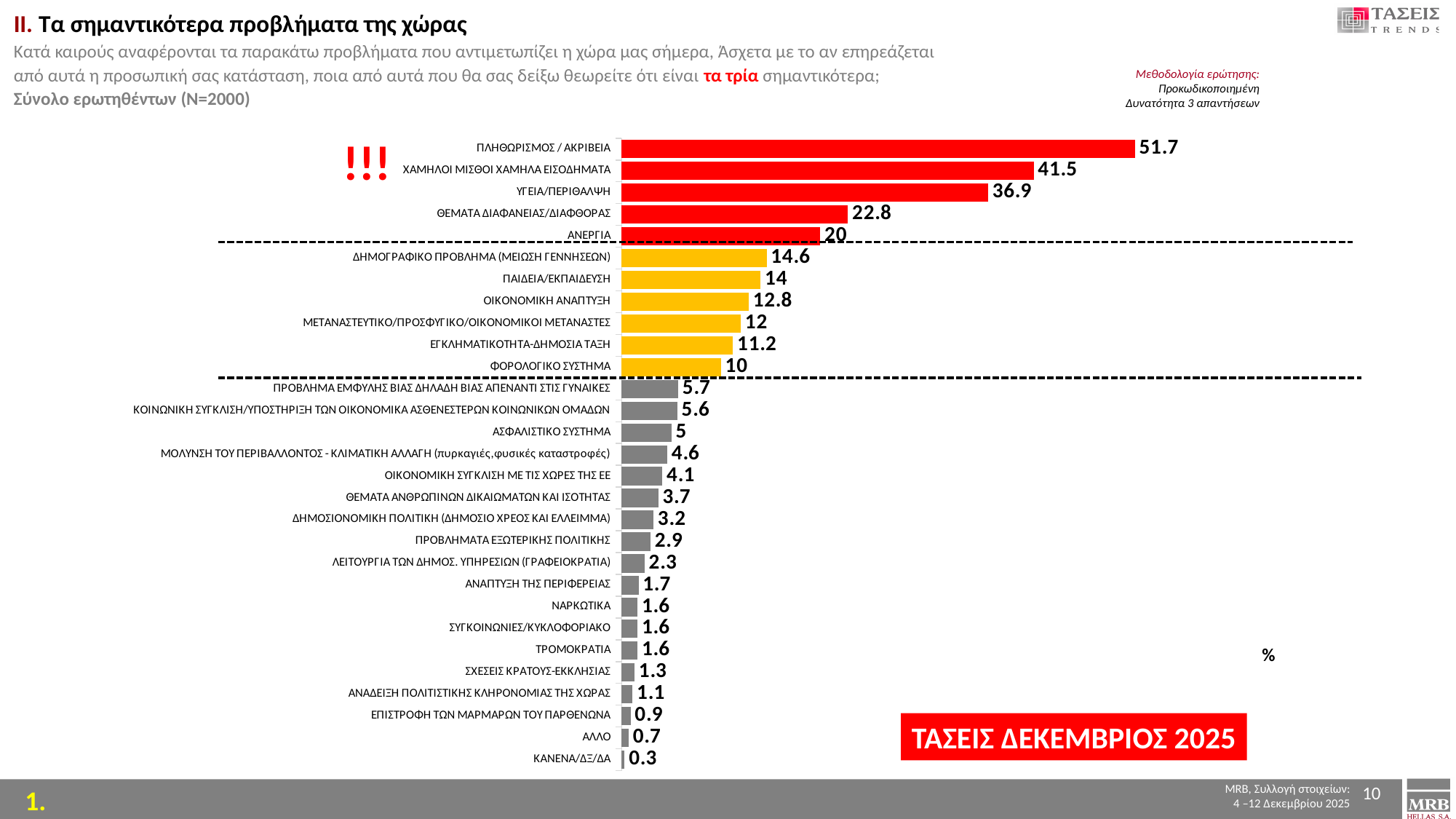
What is the difference between the values for ΠΛΗΘΩΡΙΣΜΟΣ / ΑΚΡΙΒΕΙΑ and ΧΑΜΗΛΟΙ ΜΙΣΘΟΙ ΧΑΜΗΛΑ ΕΙΣΟΔΗΜΑΤΑ? 10.2 What is the value for ΦΟΡΟΛΟΓΙΚΟ ΣΥΣΤΗΜΑ? 10 How many categories are shown in the chart? 29 What is the value for ΑΝΕΡΓΙΑ? 20 Which is larger, the value for ΔΗΜΟΓΡΑΦΙΚΟ ΠΡΟΒΛΗΜΑ (ΜΕΙΩΣΗ ΓΕΝΝΗΣΕΩΝ) or the value for ΟΙΚΟΝΟΜΙΚΗ ΑΝΑΠΤΥΞΗ? ΔΗΜΟΓΡΑΦΙΚΟ ΠΡΟΒΛΗΜΑ (ΜΕΙΩΣΗ ΓΕΝΝΗΣΕΩΝ) What is the value for ΕΠΙΣΤΡΟΦΗ ΤΩΝ ΜΑΡΜΑΡΩΝ ΤΟΥ ΠΑΡΘΕΝΩΝΑ? 0.9 What kind of chart is shown on the slide? Bar chart What colour are the bars for the top five categories? Red Which category has the highest value? ΠΛΗΘΩΡΙΣΜΟΣ / ΑΚΡΙΒΕΙΑ Which category has the lowest value? ΚΑΝΕΝΑ/ΔΞ/ΔΑ What is the value for ΠΛΗΘΩΡΙΣΜΟΣ / ΑΚΡΙΒΕΙΑ? 51.7 What is the difference between the values for ΥΓΕΙΑ/ΠΕΡΙΘΑΛΨΗ and ΘΕΜΑΤΑ ΔΙΑΦΑΝΕΙΑΣ/ΔΙΑΦΘΟΡΑΣ? 14.1